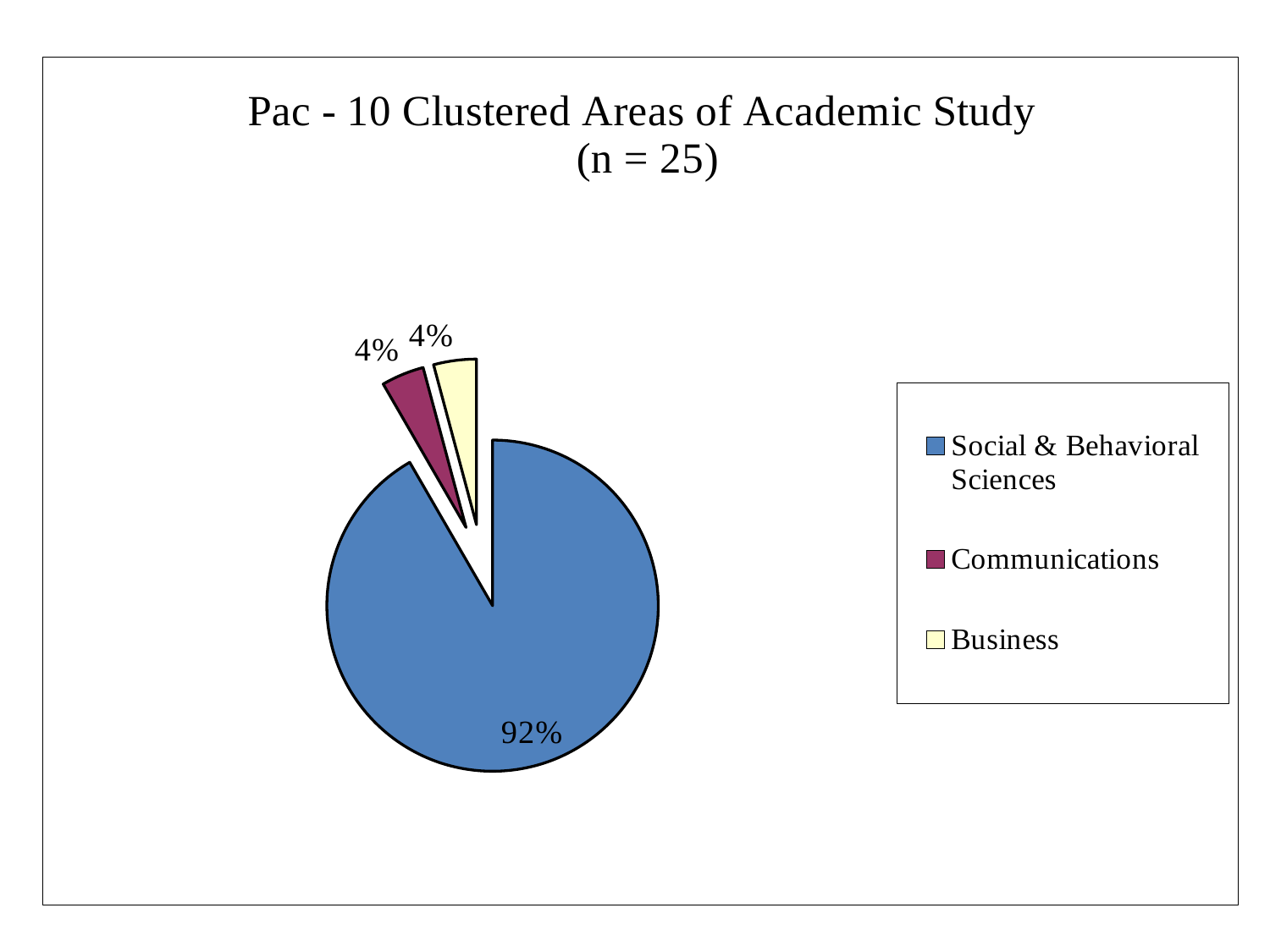
Which two categories share the smallest slice of the pie? Communications and Business How many categories are shown in the pie chart? 3 What is the title of the chart? Pac - 10 Clustered Areas of Academic Study (n = 25) What is the value shown for Communications? 4% How many entries does the legend list? 3 What is the difference in percentage points between Social & Behavioral Sciences and Business? 88 percentage points What is the value shown for Business? 4% Which is larger, the slice for Social & Behavioral Sciences or the slice for Communications? Social & Behavioral Sciences Which category has the largest slice of the pie? Social & Behavioral Sciences What share of the pie does Social & Behavioral Sciences account for? 92% What kind of chart is shown on the slide? pie chart Which category is shown in blue in the pie chart? Social & Behavioral Sciences